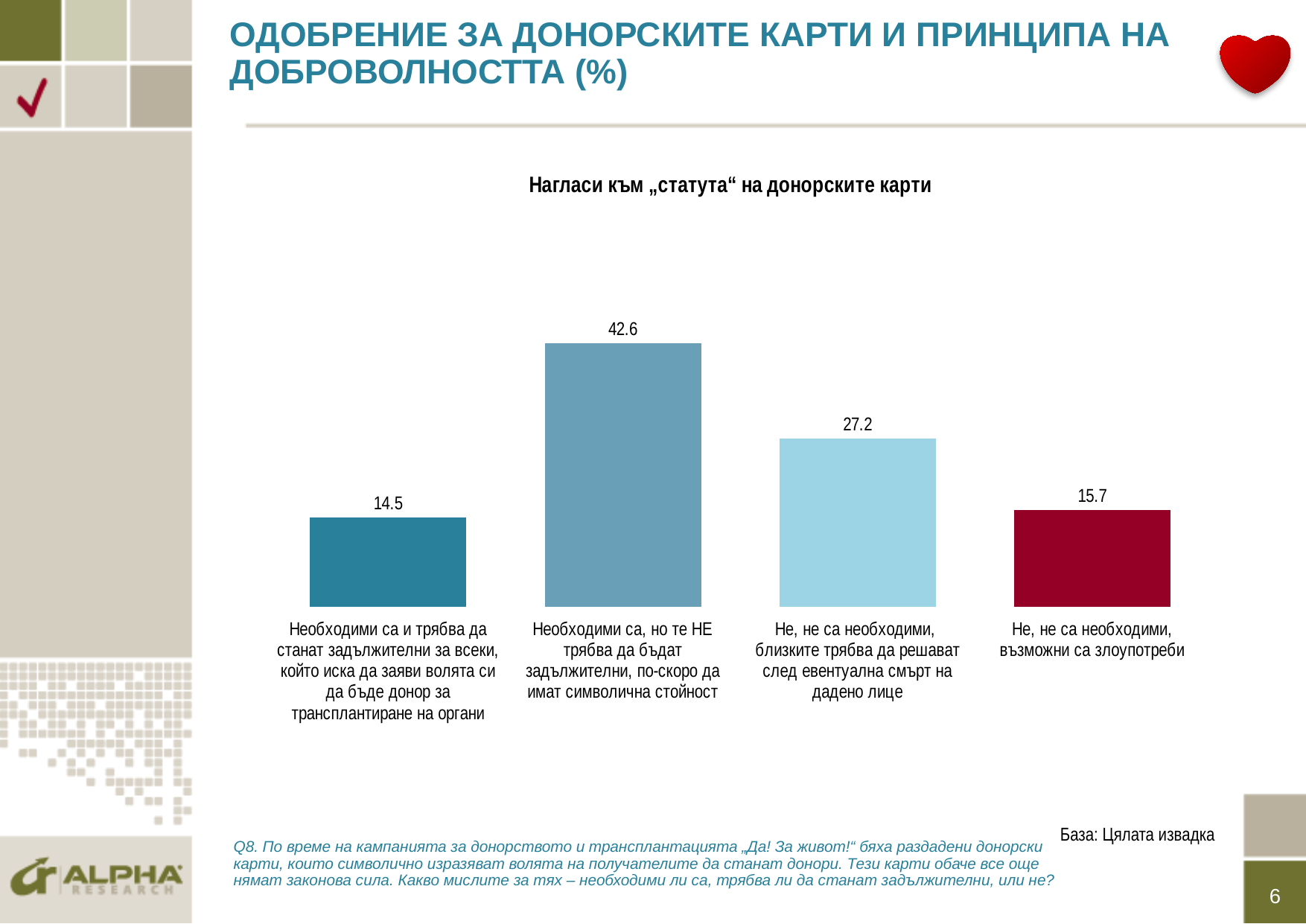
What is the value for the category "Не, не са необходими, възможни са злоупотреби"? 15.7 Which category has the lowest value? Необходими са и трябва да станат задължителни за всеки, който иска да заяви волята си да бъде донор за трансплантиране на органи What is the difference between the values for "Не, не са необходими, възможни са злоупотреби" and "Необходими са и трябва да станат задължителни за всеки..."? 1.2 What is the value for the category "Необходими са и трябва да станат задължителни за всеки, който иска да заяви волята си да бъде донор за трансплантиране на органи"? 14.5 What is the value for the category "Не, не са необходими, близките трябва да решават след евентуална смърт на дадено лице"? 27.2 What is the value for the category "Необходими са, но те НЕ трябва да бъдат задължителни, по-скоро да имат символична стойност"? 42.6 How many categories are shown in the chart? 4 What is the difference between the highest value (42.6) and the value for "Не, не са необходими, близките трябва да решават след евентуална смърт на дадено лице" (27.2)? 15.4 Which category has the highest value? Необходими са, но те НЕ трябва да бъдат задължителни, по-скоро да имат символична стойност Which is larger: the value for "Не, не са необходими, близките трябва да решават..." or the value for "Не, не са необходими, възможни са злоупотреби"? Не, не са необходими, близките трябва да решават след евентуална смърт на дадено лице What is the title of the chart? Нагласи към „статута“ на донорските карти What kind of chart is shown on the slide? Bar chart